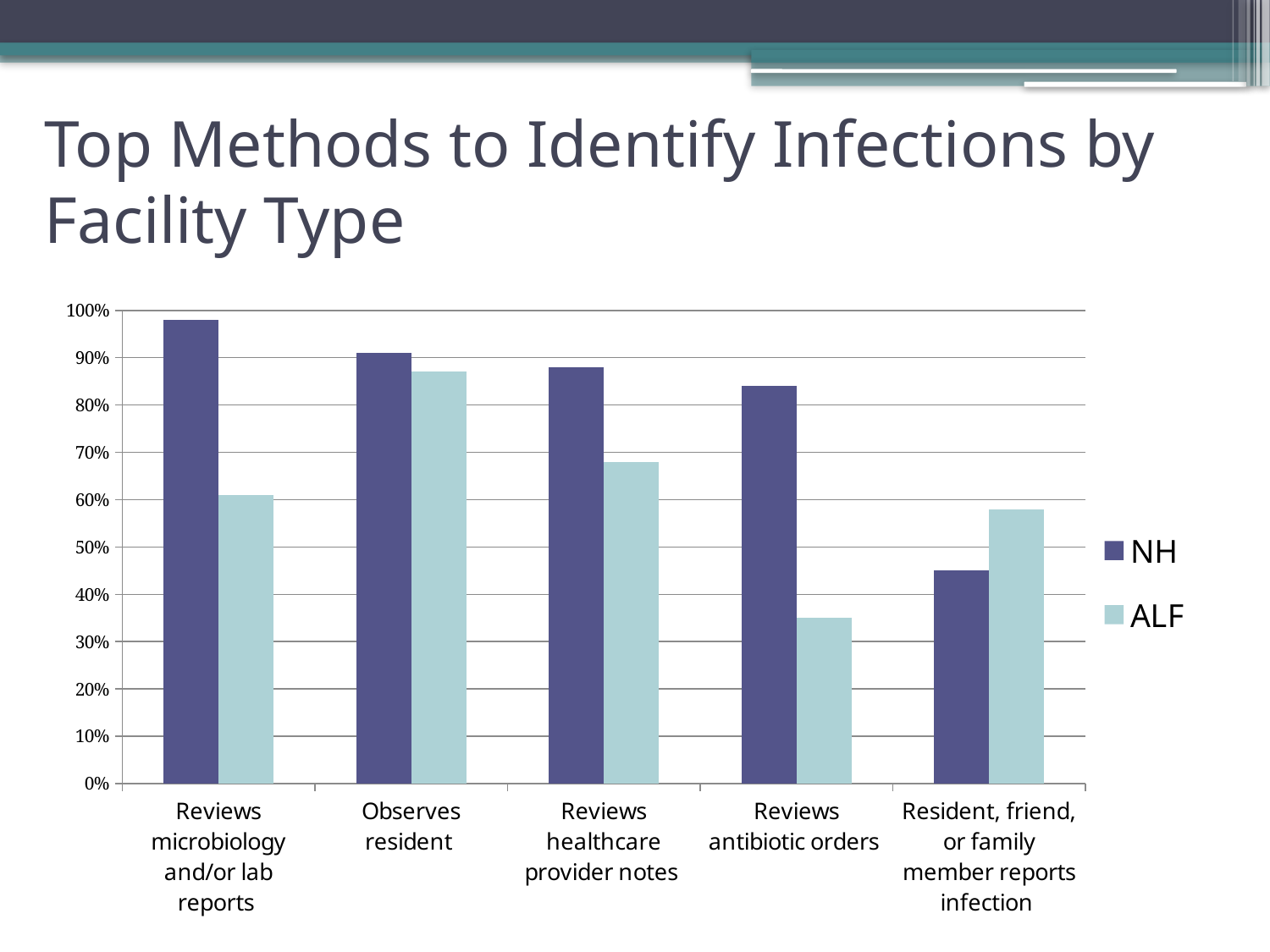
Which method has the highest value for ALF? Observes resident Which method has the lowest value for NH? Resident, friend, or family member reports infection How many series does the legend list? 2 Is the NH value for Resident, friend, or family member reports infection greater or less than 50%? less Is the NH value for Reviews microbiology and/or lab reports greater or less than 90%? greater Is the ALF value for Reviews antibiotic orders greater or less than 40%? less How many identification methods (categories) are shown on the x axis? 5 Do the NH values rise or fall moving from left to right across the categories? fall For Resident, friend, or family member reports infection, which is larger, NH or ALF? ALF Which method has the highest value for NH? Reviews microbiology and/or lab reports Which method has the lowest value for ALF? Reviews antibiotic orders What type of chart is shown on the slide? Bar chart